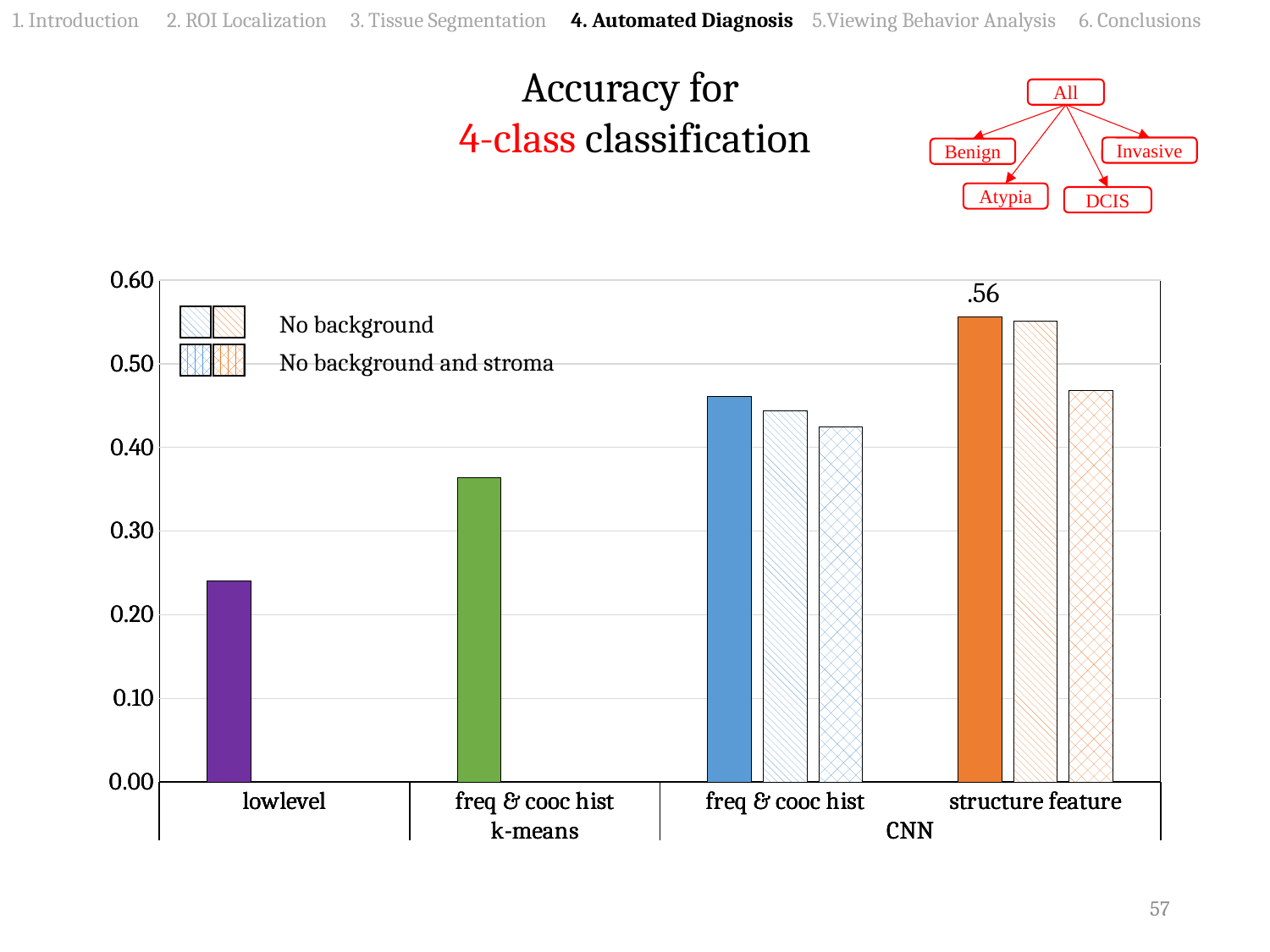
Is the accuracy for lowlevel greater or less than 0.30? less How many categories are shown on the x axis of the chart? 4 Is the accuracy for freq & cooc hist under k-means greater or less than 0.30? greater What kind of chart is shown on the slide? bar chart What is the labeled accuracy value for the solid structure feature bar under CNN? .56 Is the accuracy of the 'No background and stroma' bar for structure feature greater or less than 0.50? less What are the two entries listed in the chart legend? No background; No background and stroma Which category has the lowest accuracy? lowlevel Which category has the highest accuracy? structure feature Do the solid bars rise or fall from left to right across the categories? rise Which is larger, the accuracy for lowlevel or for freq & cooc hist under k-means? freq & cooc hist under k-means